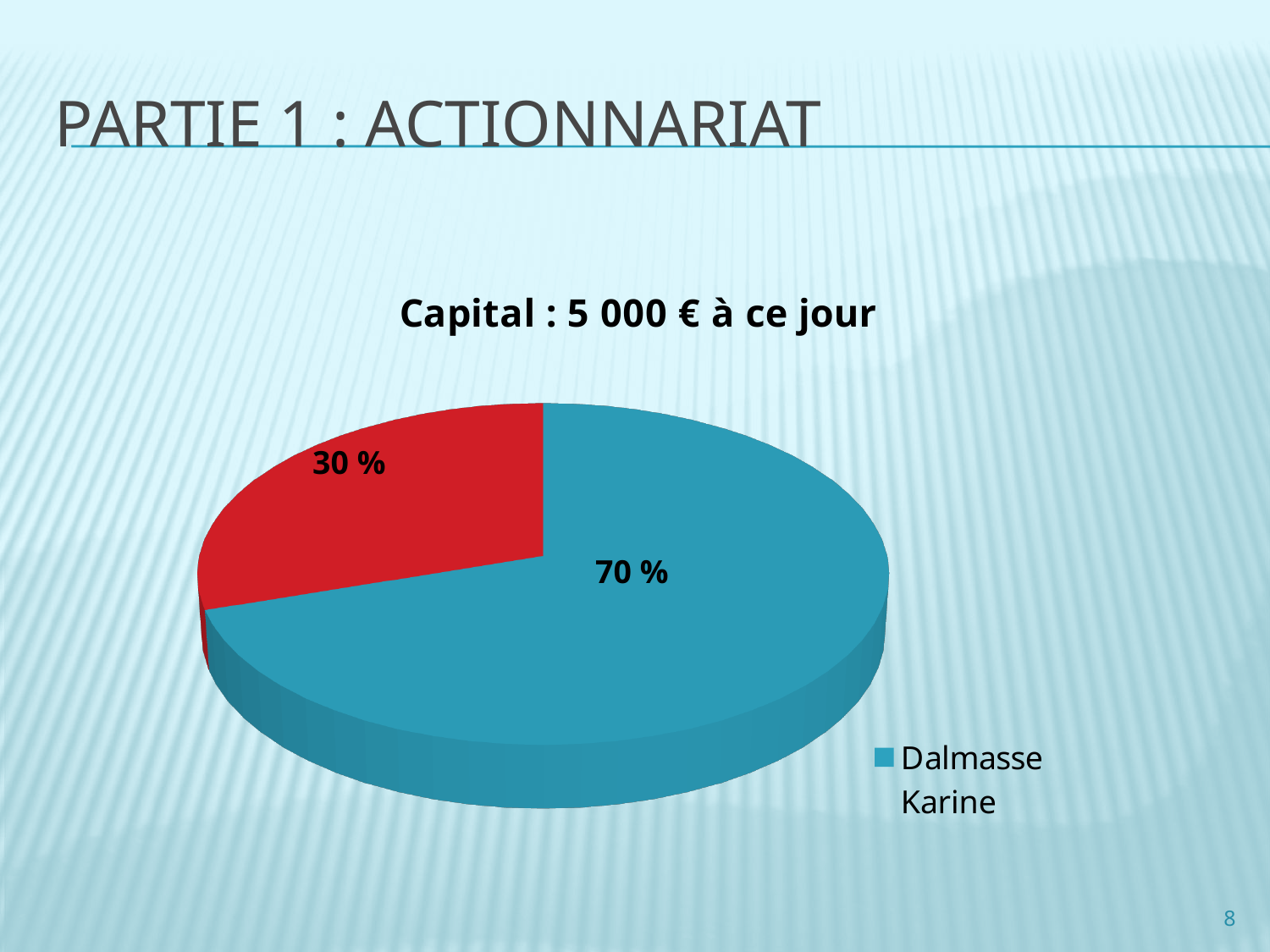
What is the value printed on the red slice of the pie? 30 % Which slice of the pie is the largest? Dalmasse Karine (70 %) How many slices does the pie chart have? 2 Is the value for Dalmasse Karine greater or less than 50 %? greater What is the chart's title? Capital : 5 000 € à ce jour Which is larger: the blue slice or the red slice? the blue slice What is the value of the smallest slice of the pie? 30 % What is the difference between the 70 % slice and the 30 % slice? 40 % How many entries does the legend list? 1 What colour is the slice for Dalmasse Karine? blue What share of the pie does Dalmasse Karine hold? 70 % What kind of chart is shown on the slide? pie chart